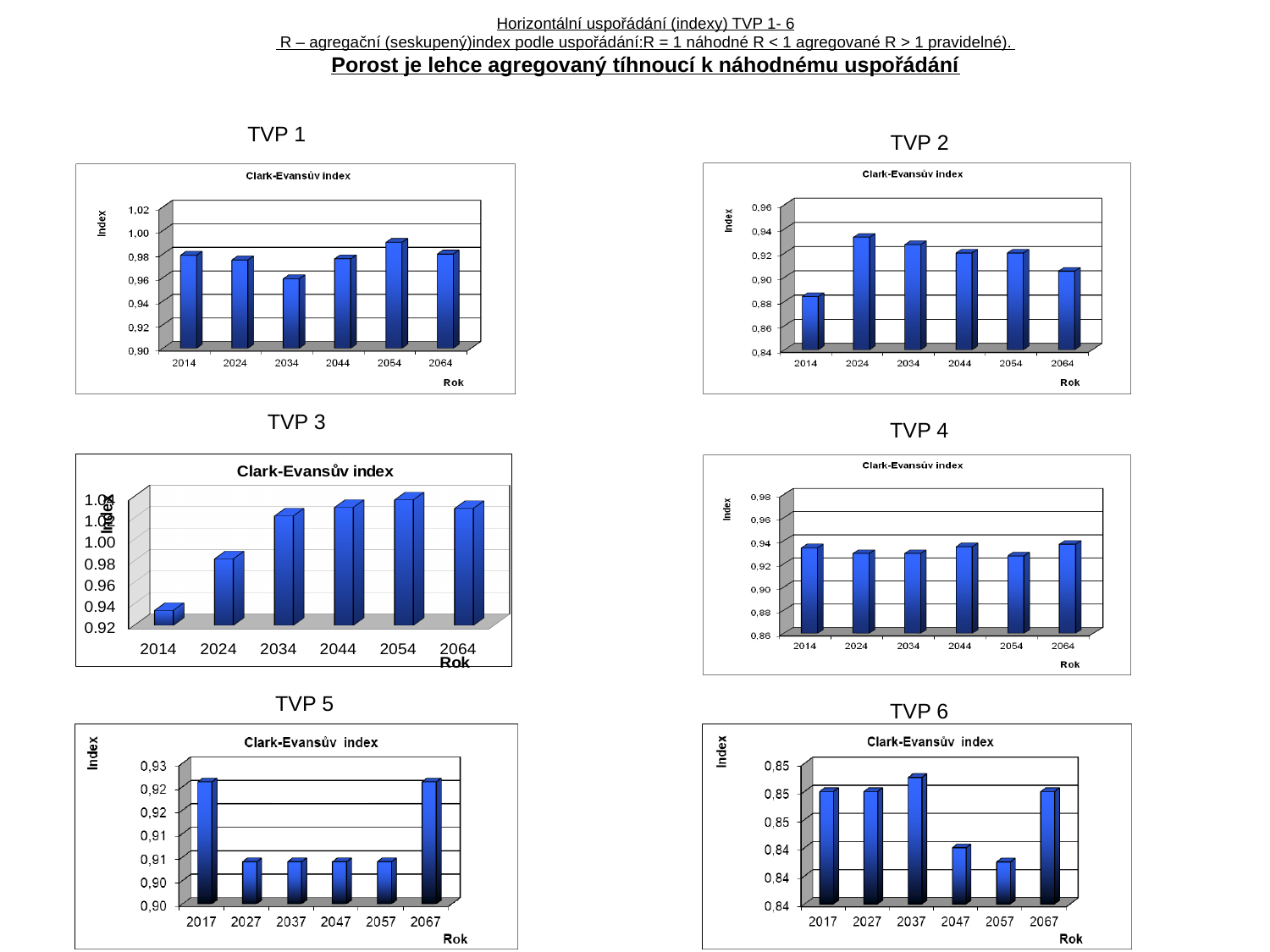
In the TVP 5 chart, which is larger, the value for 2017 or the value for 2027? 2017 In the TVP 2 chart, which year has the lowest value? 2014 In the TVP 1 chart, which year has the lowest Clark-Evansův index? 2034 In the TVP 1 chart, which year has the highest Clark-Evansův index? 2054 In the TVP 3 chart, which year has the lowest value? 2014 How many bars (years) are plotted in the TVP 2 chart? 6 What is the title shown inside the TVP 4 chart? Clark-Evansův index In the TVP 3 chart, is the value for 2054 greater or less than 1.00? greater In the TVP 2 chart, is the value for 2014 greater or less than 0,90? less What kind of chart is the TVP 1 chart? bar chart In the TVP 6 chart, which year has the highest value? 2037 In the TVP 3 chart, do the values generally rise or fall from 2014 to 2054? rise